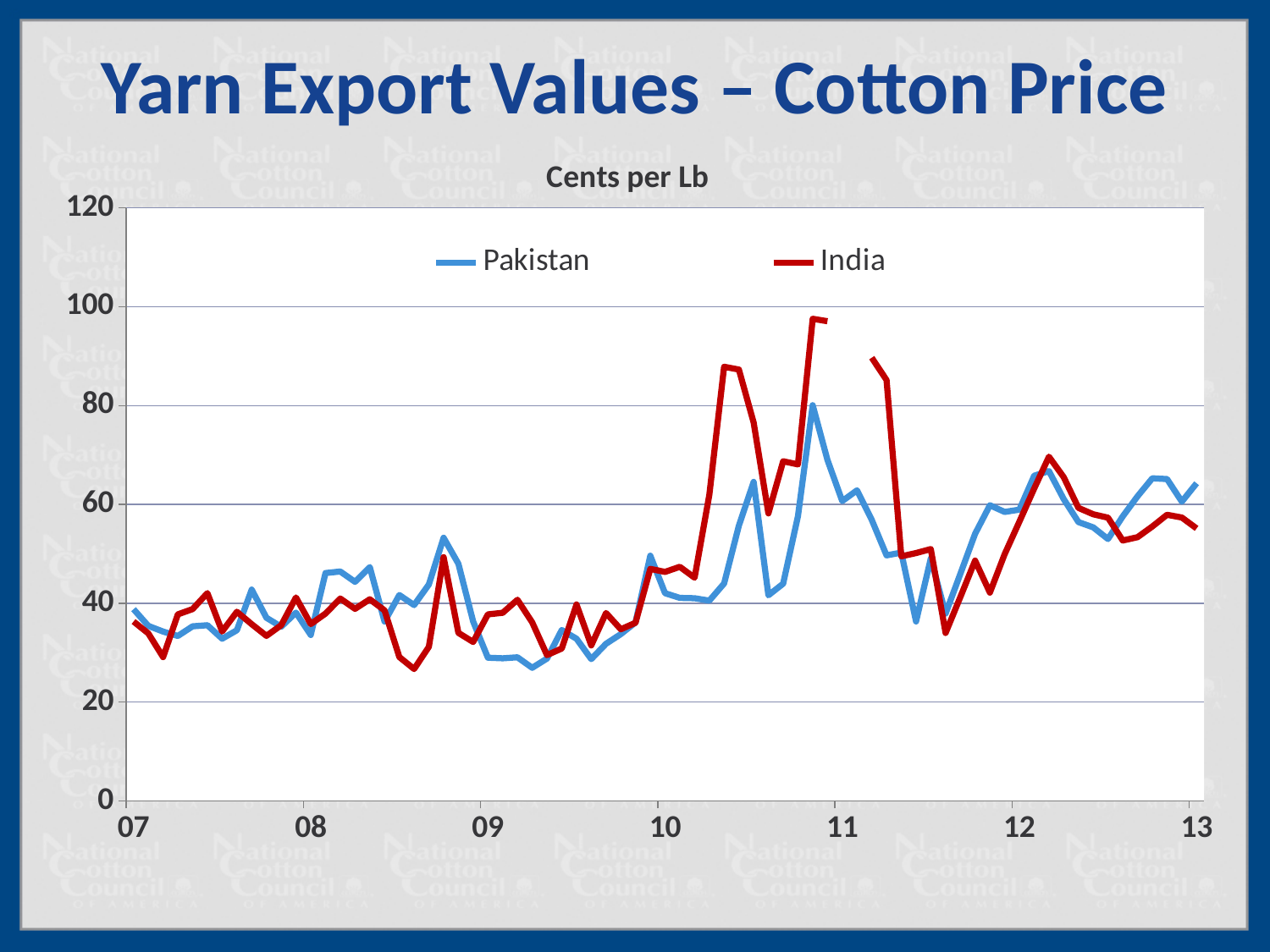
How many year labels appear on the x axis? 7 Does the Pakistan line rise or fall between 09 and 10? rise What kind of chart is shown on the slide? line chart Which two series are shown in the legend? Pakistan and India At 13, which series has the higher value, Pakistan or India? Pakistan How many series does the legend list? 2 What unit is given in the chart's subtitle? Cents per Lb Is the highest value reached by the India line greater or less than 80? greater Is the value for Pakistan at 09 greater or less than 40? less Is the value for Pakistan at 13 greater or less than 60? greater Which series reaches the highest value anywhere on the chart? India